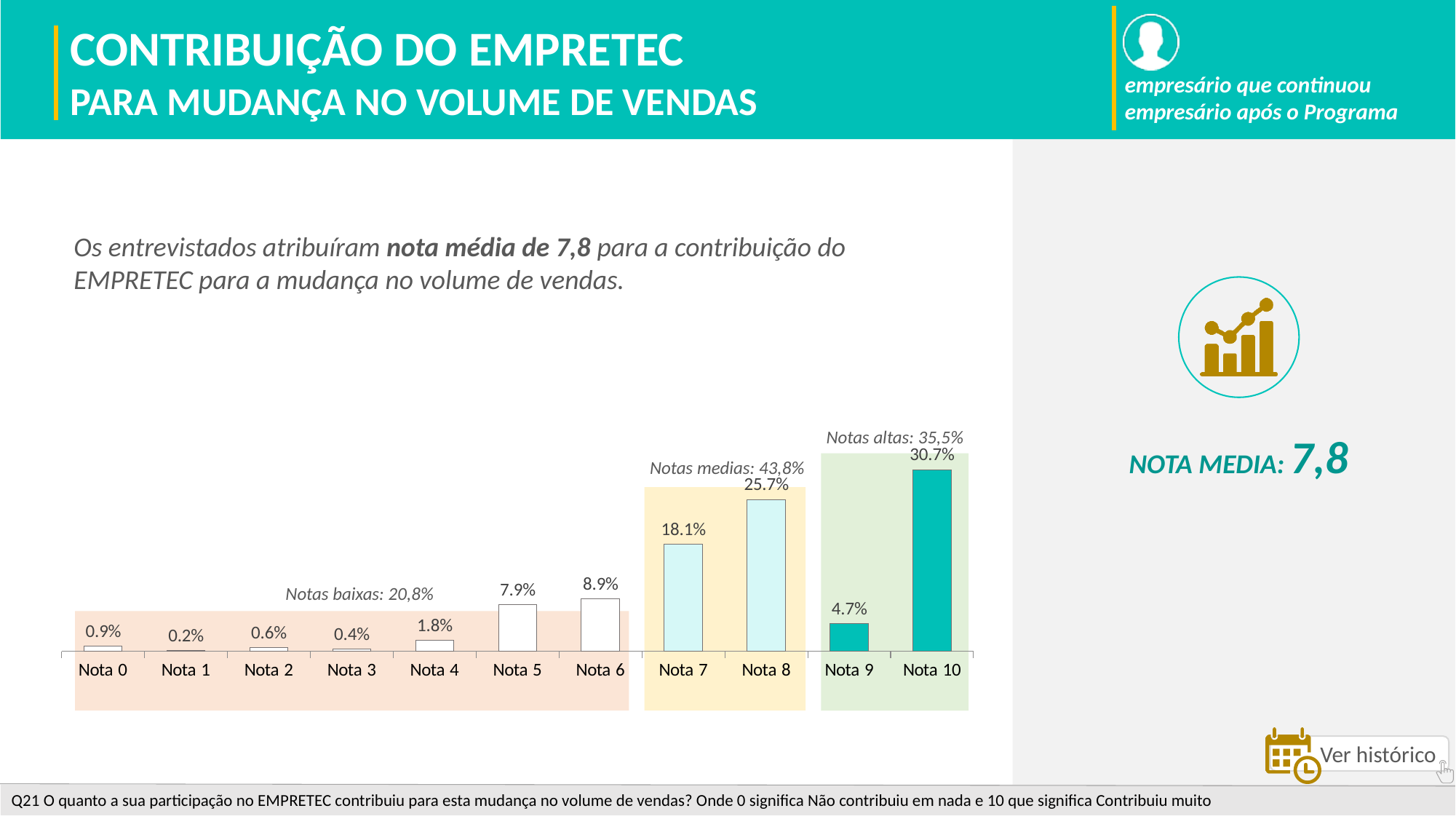
Which category has the lowest value? Nota 1 What is the combined share labelled for the 'Notas baixas' group? 20,8% What is the value for Nota 1? 0.2% Which is larger, the value for Nota 6 or the value for Nota 9? Nota 6 What is the combined share labelled for the 'Notas altas' group? 35,5% What is the difference between the values for Nota 10 and Nota 8? 5.0% What is the value for Nota 7? 18.1% How many categories are shown on the x axis? 11 What is the value for Nota 10? 30.7% What is the 'NOTA MEDIA' value shown on the slide? 7,8 Which category has the highest value? Nota 10 What kind of chart is shown on the slide? Bar chart